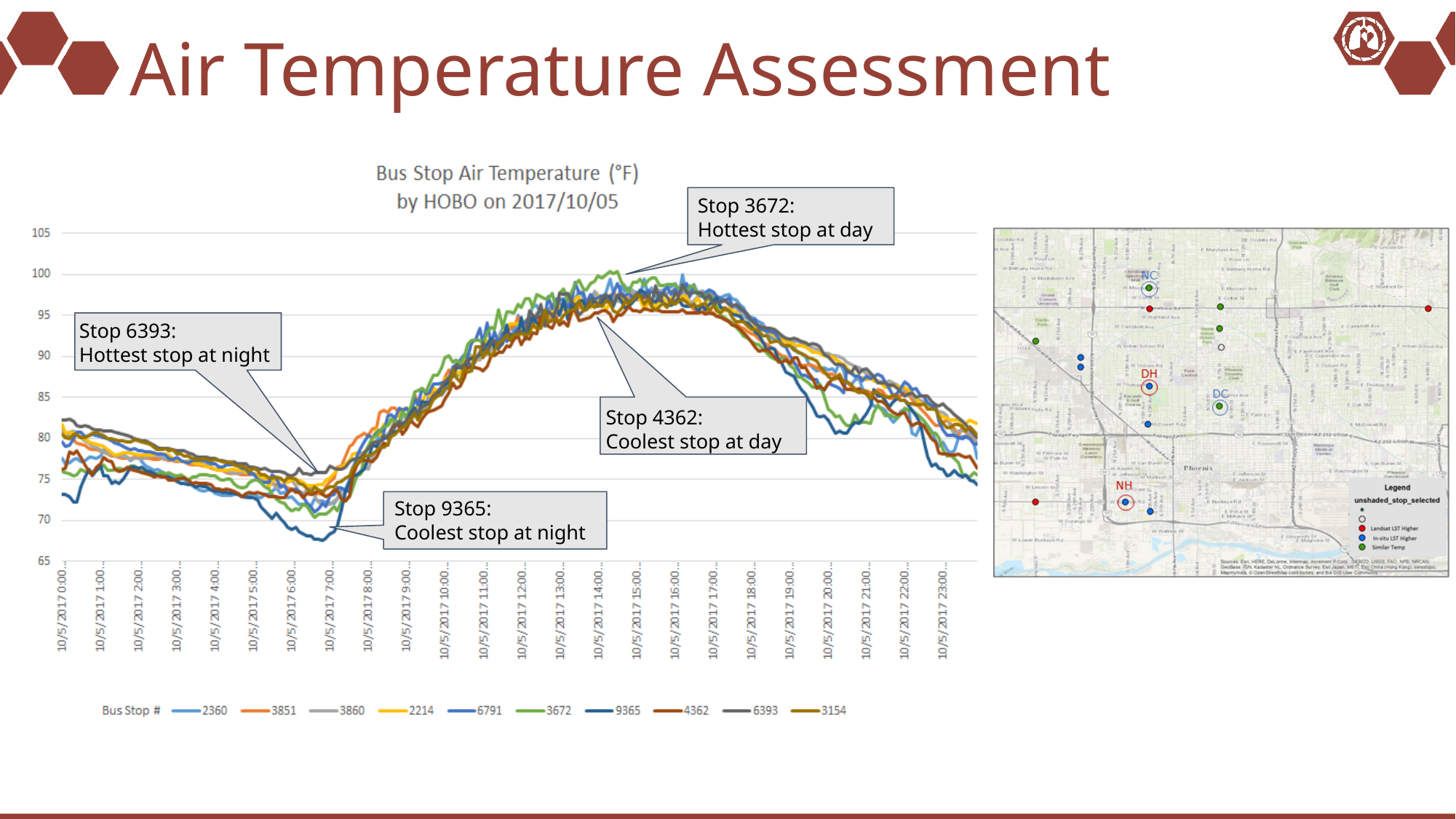
Do the temperatures rise or fall between 10/5/2017 16:00 and 10/5/2017 23:00? fall According to the annotation on the chart, which stop is the coolest stop at night? Stop 9365 Is the lowest value for stop 9365 around 10/5/2017 7:00 greater or less than 70? less How many bus stop series does the legend of the Bus Stop Air Temperature chart list? 10 According to the annotation on the chart, which stop is the hottest stop at night? Stop 6393 Is the peak value for stop 3672 around 10/5/2017 14:00 greater or less than 95? greater What is the title of the line chart? Bus Stop Air Temperature (°F) by HOBO on 2017/10/05 According to the annotation on the chart, which stop is the coolest stop at day? Stop 4362 What is the legend title of the line chart? Bus Stop # According to the annotation on the chart, which stop is the hottest stop at day? Stop 3672 What kind of chart is the Bus Stop Air Temperature chart? line chart Do the temperatures rise or fall between 10/5/2017 7:00 and 10/5/2017 14:00? rise